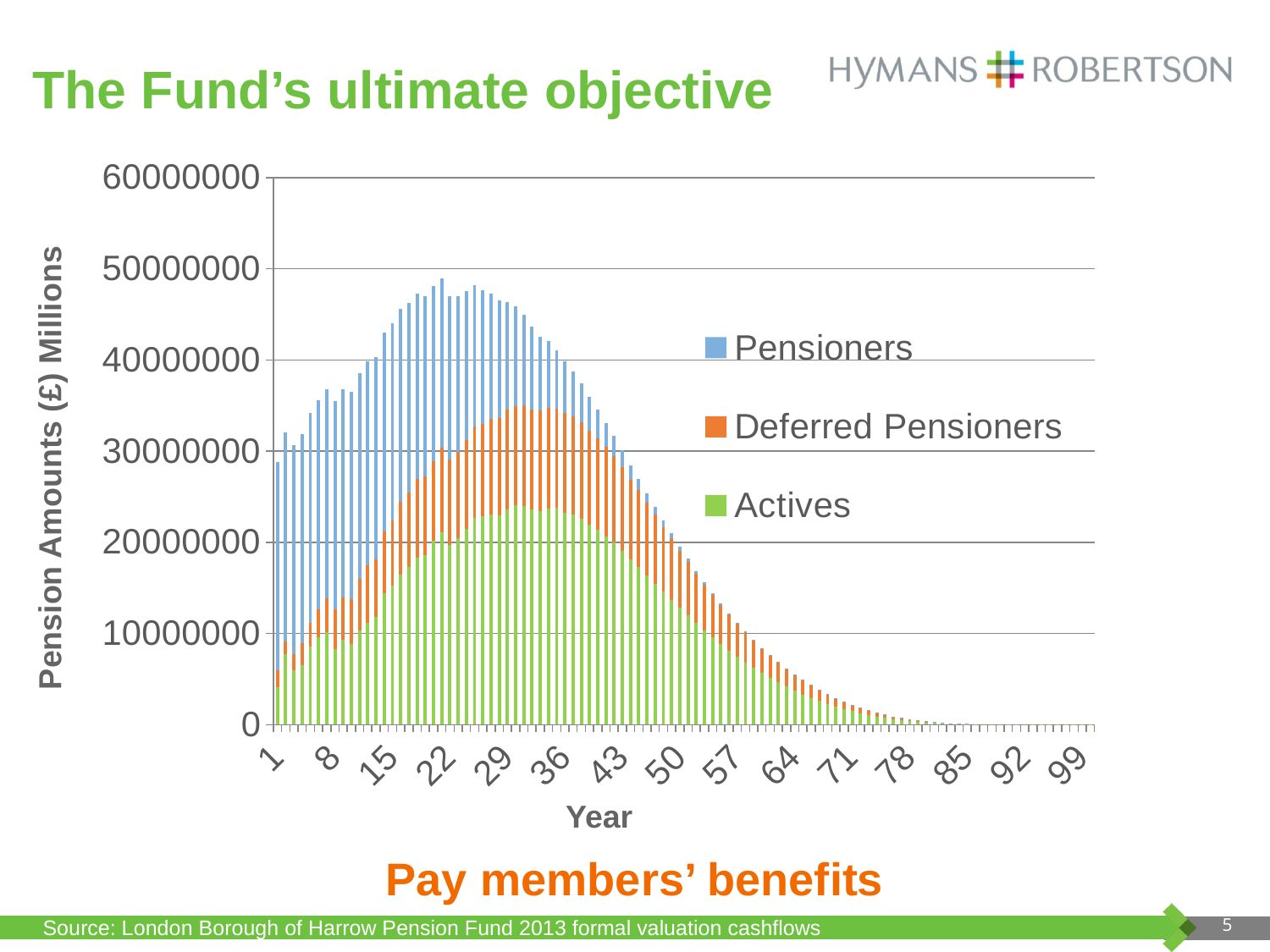
How many series does the chart's legend list? 3 What kind of chart is shown on the slide? Stacked bar chart Which series is shown in green in the chart? Actives Is the Actives amount for year 1 greater or less than 10000000? less Is the total pension amount for year 99 greater or less than 10000000? less Is the total pension amount for year 22 greater or less than 40000000? greater Which year has the larger total pension amount: year 8 or year 64? Year 8 Between year 50 and year 99, do the total pension amounts rise or fall along the x axis? Fall What is the title of the chart's vertical axis? Pension Amounts (£) Millions Which is larger at year 1: the Pensioners amount or the Actives amount? Pensioners